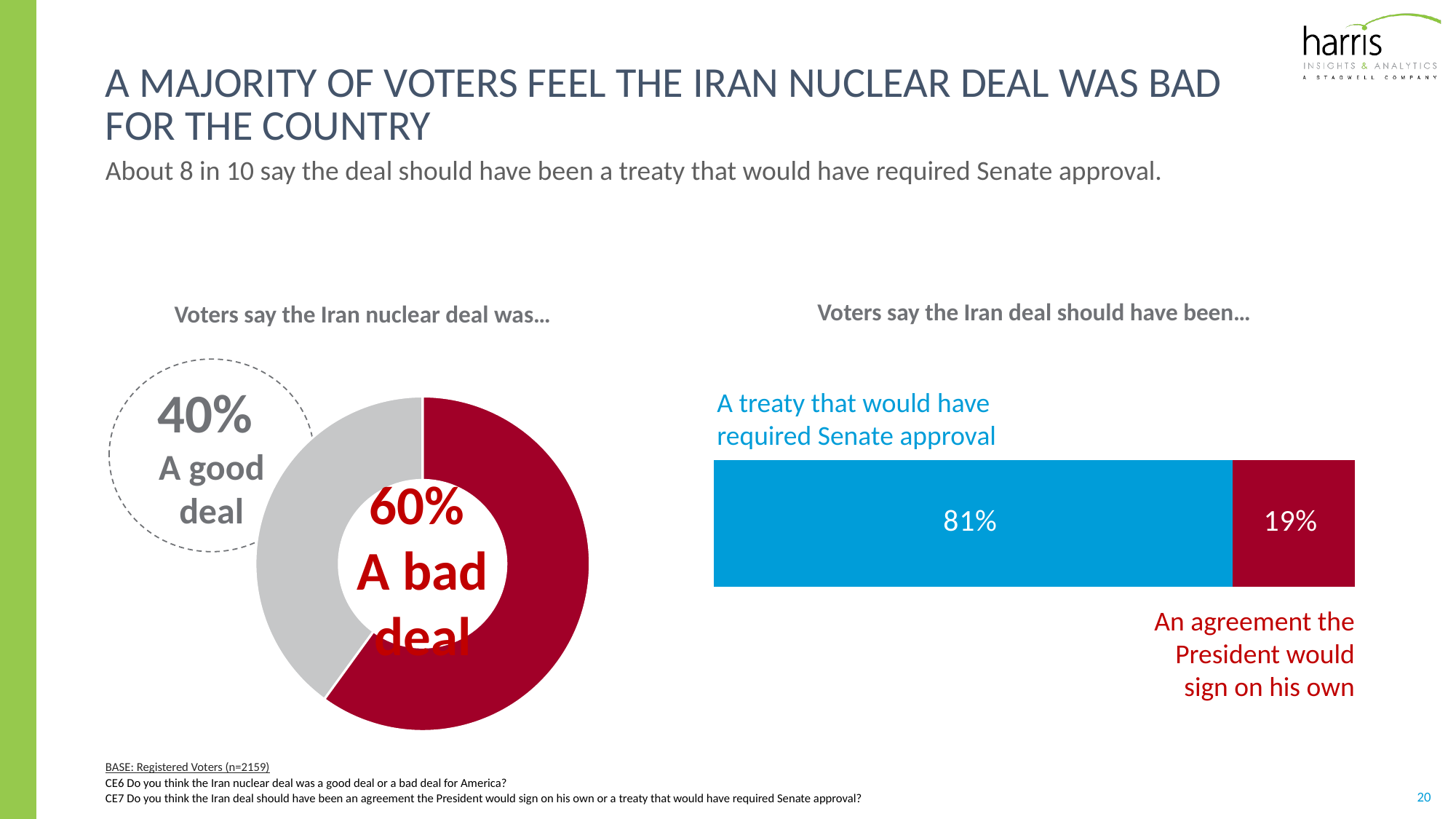
In the chart titled "Voters say the Iran deal should have been...", what do the two segments add up to? 100% In the chart titled "Voters say the Iran deal should have been...", what percentage say it should have been an agreement the President would sign on his own? 19% In the chart titled "Voters say the Iran nuclear deal was...", what is the difference between the share saying a bad deal and the share saying a good deal? 20% In the chart titled "Voters say the Iran deal should have been...", what is the difference between the treaty share and the agreement share? 62% What kind of chart is the one titled "Voters say the Iran deal should have been..."? Stacked bar chart In the chart titled "Voters say the Iran deal should have been...", which response has the smaller share? An agreement the President would sign on his own In the chart titled "Voters say the Iran deal should have been...", what percentage say it should have been a treaty that would have required Senate approval? 81% In the chart titled "Voters say the Iran nuclear deal was...", what percentage of voters say it was a bad deal? 60% In the chart titled "Voters say the Iran nuclear deal was...", what percentage of voters say it was a good deal? 40% What kind of chart is the one titled "Voters say the Iran nuclear deal was..."? Donut (pie) chart In the chart titled "Voters say the Iran nuclear deal was...", which response has the larger share? A bad deal In the chart titled "Voters say the Iran deal should have been...", what colour is the segment for a treaty that would have required Senate approval? Blue